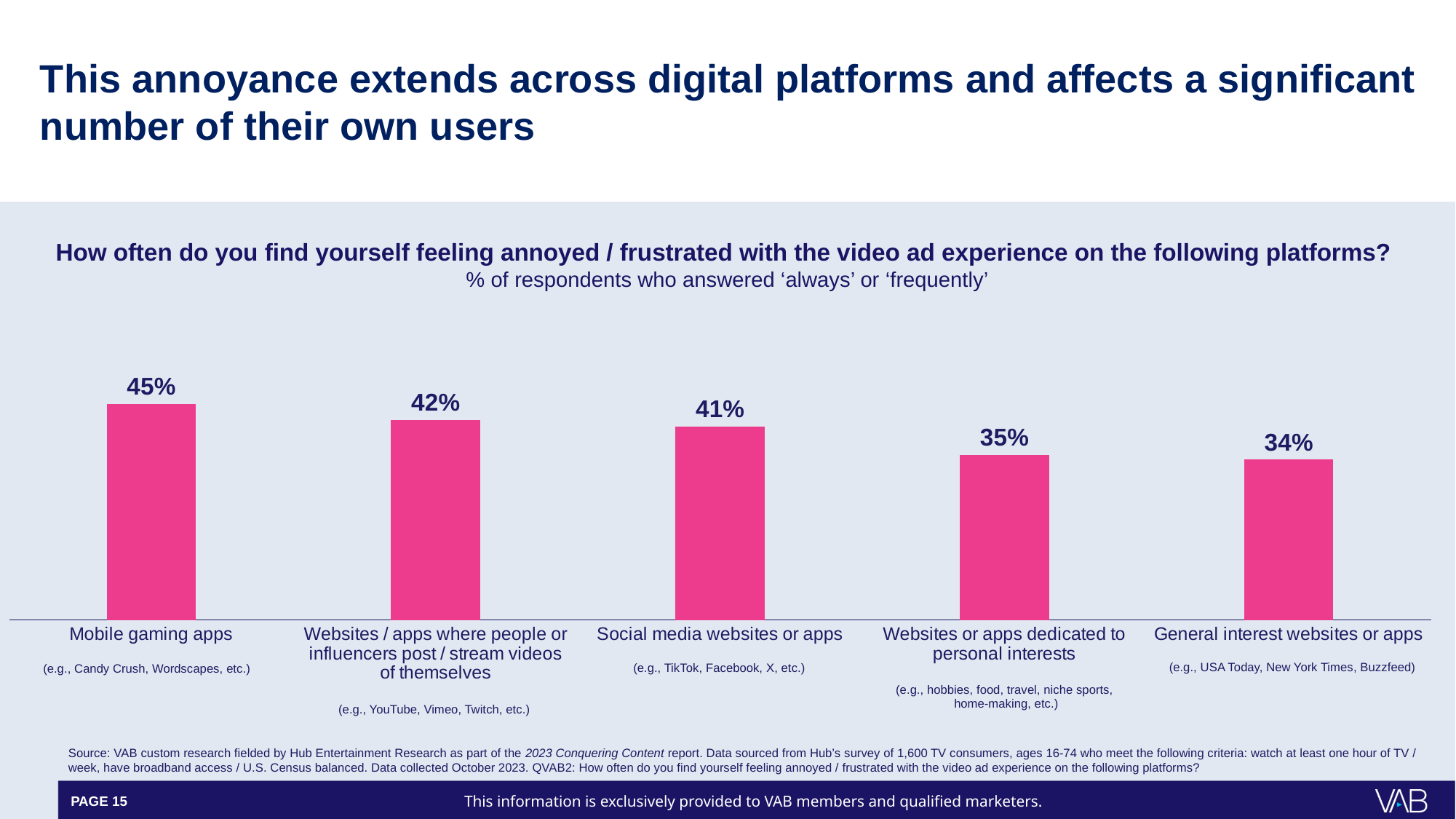
Which platform has the lowest share of respondents who answered 'always' or 'frequently'? General interest websites or apps Which is larger: the value for social media websites or apps or the value for websites or apps dedicated to personal interests? Social media websites or apps What is the value shown for general interest websites or apps? 34% What is the difference between the value for websites / apps where people or influencers post / stream videos of themselves and the value for social media websites or apps? 1 percentage point What type of chart is shown on the slide? Bar chart What is the value shown for social media websites or apps? 41% Do the values rise or fall moving from left to right across the chart? Fall How many platforms are shown in the chart? 5 Which platform has the highest share of respondents who answered 'always' or 'frequently'? Mobile gaming apps What is the difference in percentage points between mobile gaming apps and general interest websites or apps? 11 percentage points What percentage of respondents said they are always or frequently annoyed by the video ad experience on mobile gaming apps? 45% What is the value shown for websites or apps dedicated to personal interests? 35%